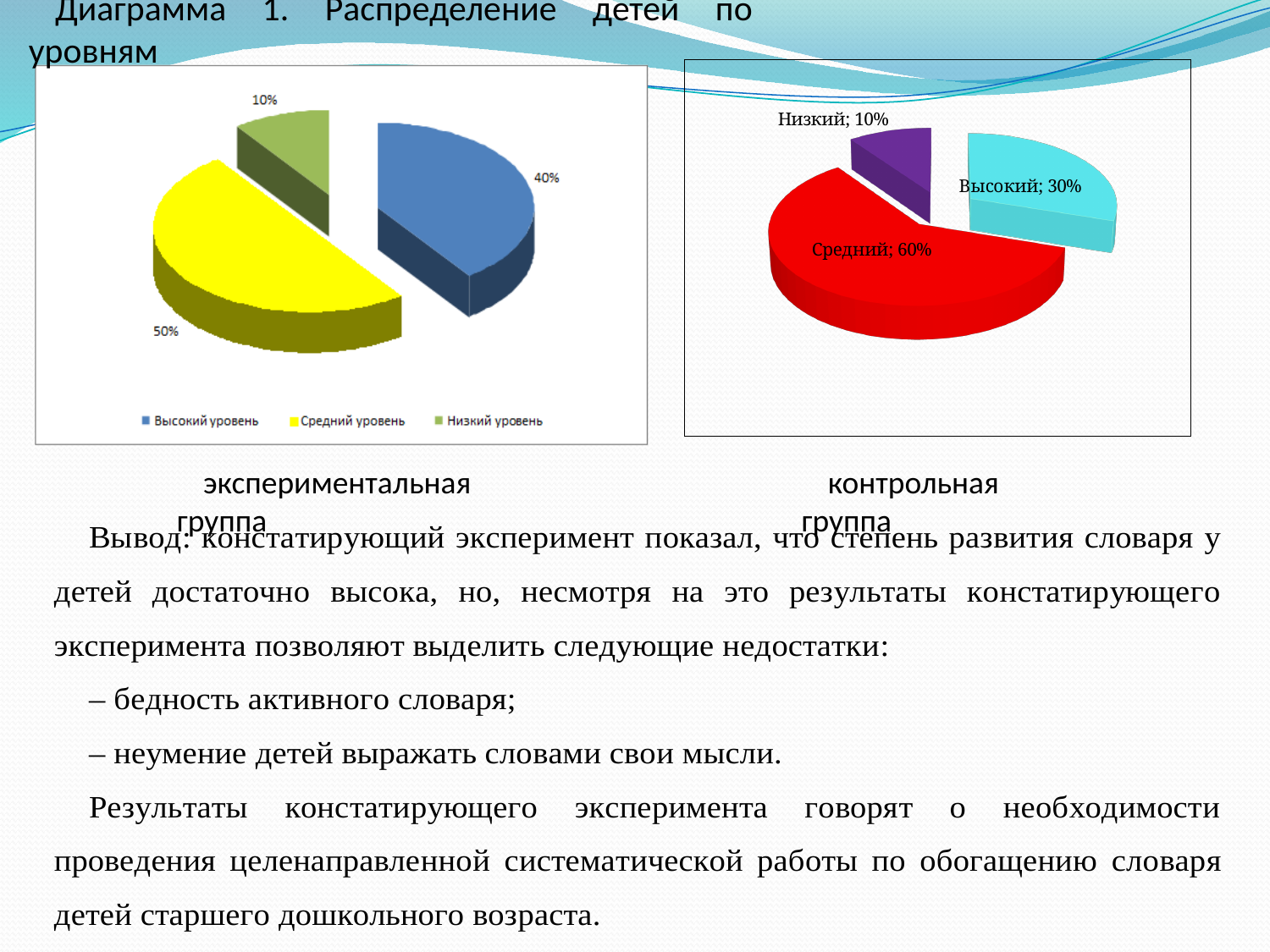
In the left pie chart (экспериментальная группа), what share is shown for Средний уровень? 50% How many slices does the right pie chart (контрольная группа) have? 3 In the right pie chart (контрольная группа), which level has the largest share? Средний In the left pie chart (экспериментальная группа), which level has the smallest share? Низкий уровень In the right pie chart (контрольная группа), what share is shown for Средний? 60% In the left pie chart (экспериментальная группа), what share is shown for Низкий уровень? 10% How many entries does the legend of the left chart (экспериментальная группа) list? 3 In the left pie chart (экспериментальная группа), what is the difference between the shares for Средний уровень and Высокий уровень? 10% Which is larger: the share for Высокий in the right chart (контрольная группа) or the share for Высокий уровень in the left chart (экспериментальная группа)? Высокий уровень in the left chart (экспериментальная группа) In the right pie chart (контрольная группа), what share is shown for Высокий? 30% What type of chart is the left chart (экспериментальная группа)? Pie chart In the left pie chart (экспериментальная группа), what share is shown for Высокий уровень? 40%